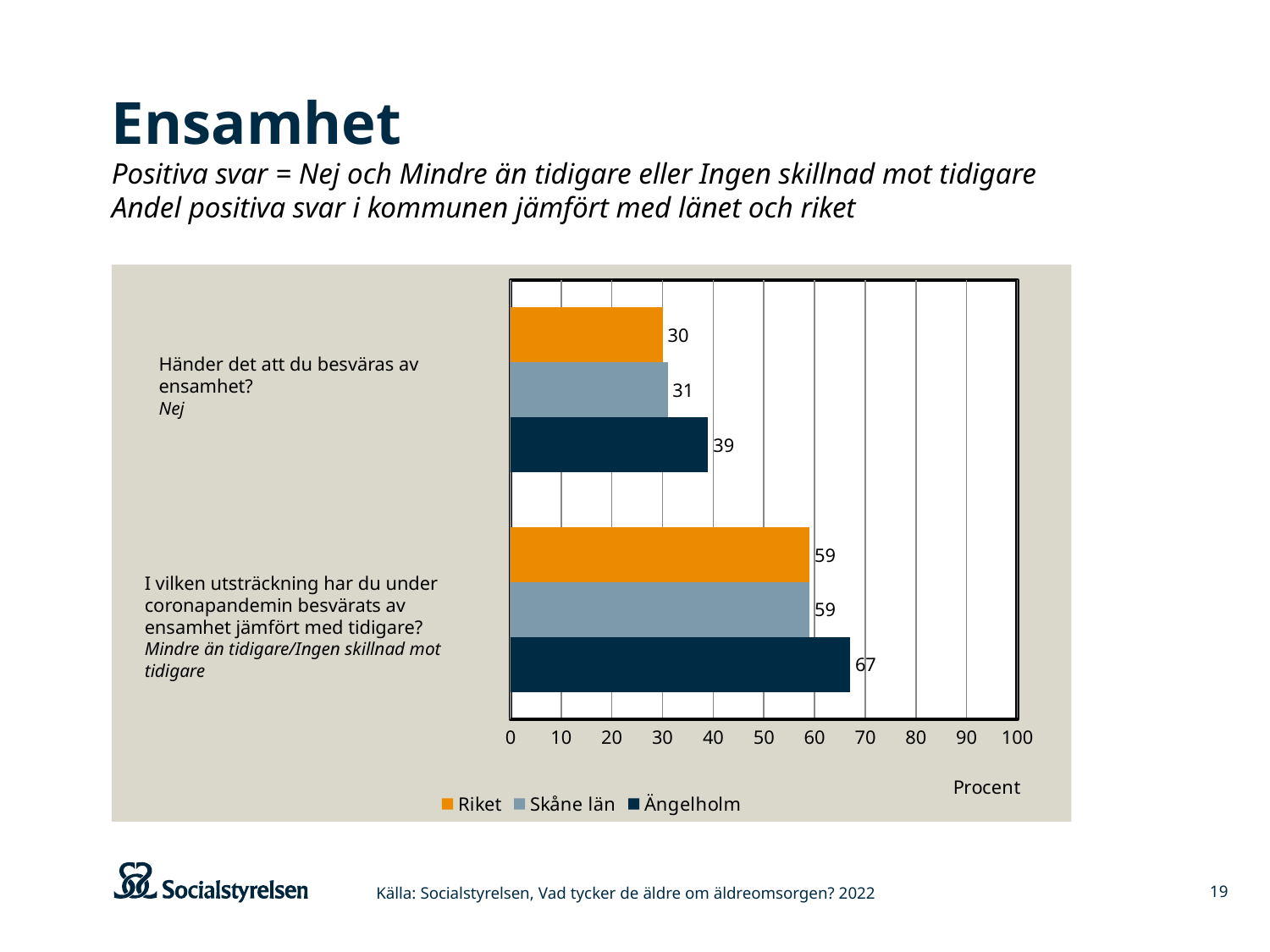
What is the value for Skåne län on the question "Händer det att du besväras av ensamhet?"? 31 What is the difference between Ängelholm and Riket on the question "Händer det att du besväras av ensamhet?"? 9 Which series has the highest value on the question "I vilken utsträckning har du under coronapandemin besvärats av ensamhet jämfört med tidigare?"? Ängelholm What kind of chart is shown on the slide? Bar chart Which series has the lowest value on the question "Händer det att du besväras av ensamhet?"? Riket How many questions (categories) are shown on the chart? 2 What unit is shown on the x axis of the chart? Procent How many series does the legend list? 3 Which is larger: Ängelholm's value for "Händer det att du besväras av ensamhet?" or Riket's value for the same question? Ängelholm What is the value for Riket on the question "I vilken utsträckning har du under coronapandemin besvärats av ensamhet jämfört med tidigare?"? 59 What is the difference between Ängelholm and Skåne län on the question "I vilken utsträckning har du under coronapandemin besvärats av ensamhet jämfört med tidigare?"? 8 What is the value for Ängelholm on the question "Händer det att du besväras av ensamhet?"? 39